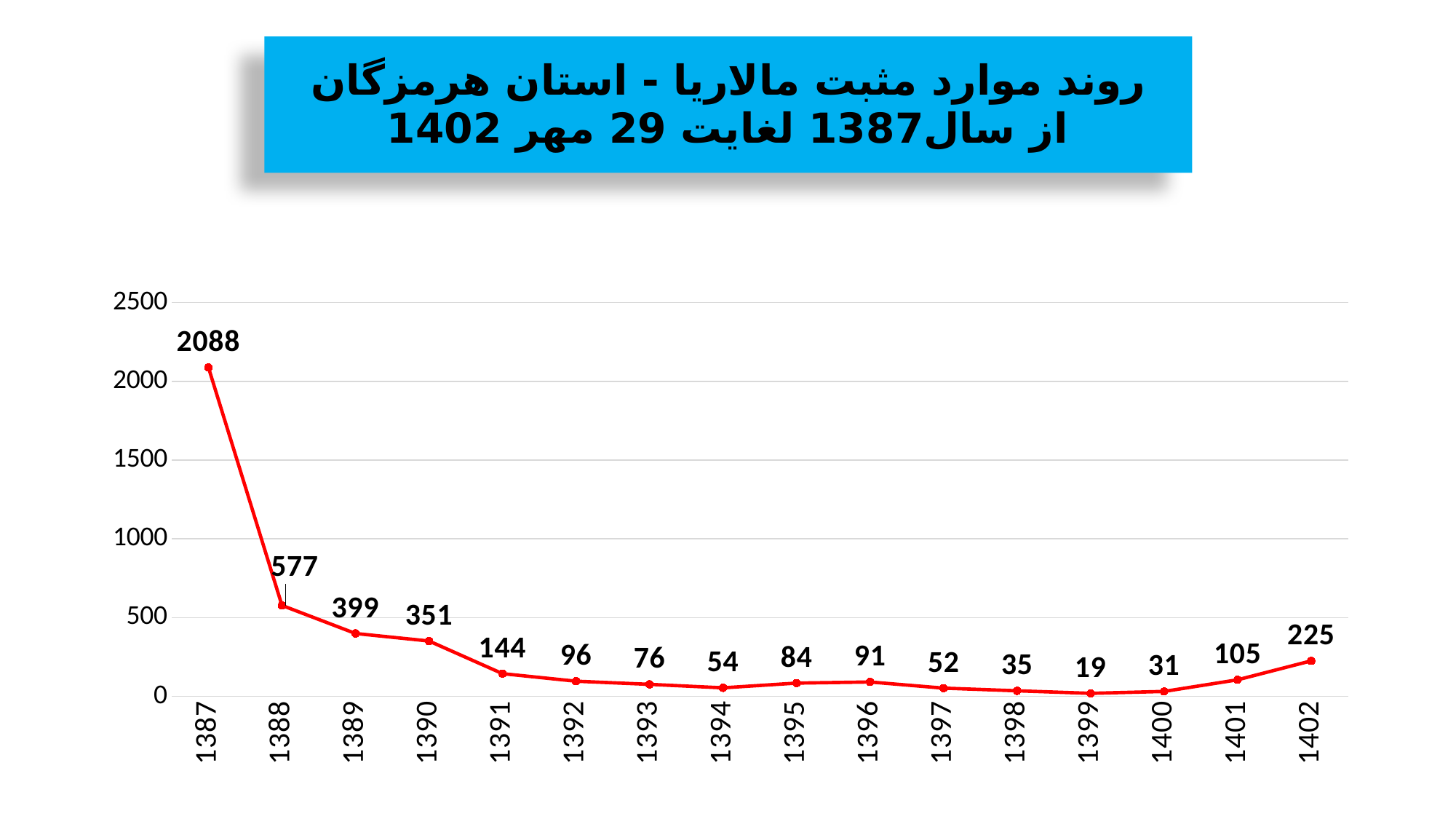
What kind of chart is shown? line chart What is the difference between the values for 1402 and 1401? 120 What is the difference between the values for 1387 and 1388? 1511 Which year has the highest value? 1387 What is the value for 1402? 225 How many years are plotted on the x axis? 16 Which is larger, the value for 1395 or the value for 1394? 1395 Is the value for 1388 greater or less than 500? greater Do the values rise or fall from 1387 to 1391? fall Which year has the lowest value? 1399 What is the value for 1387? 2088 What is the value for 1399? 19